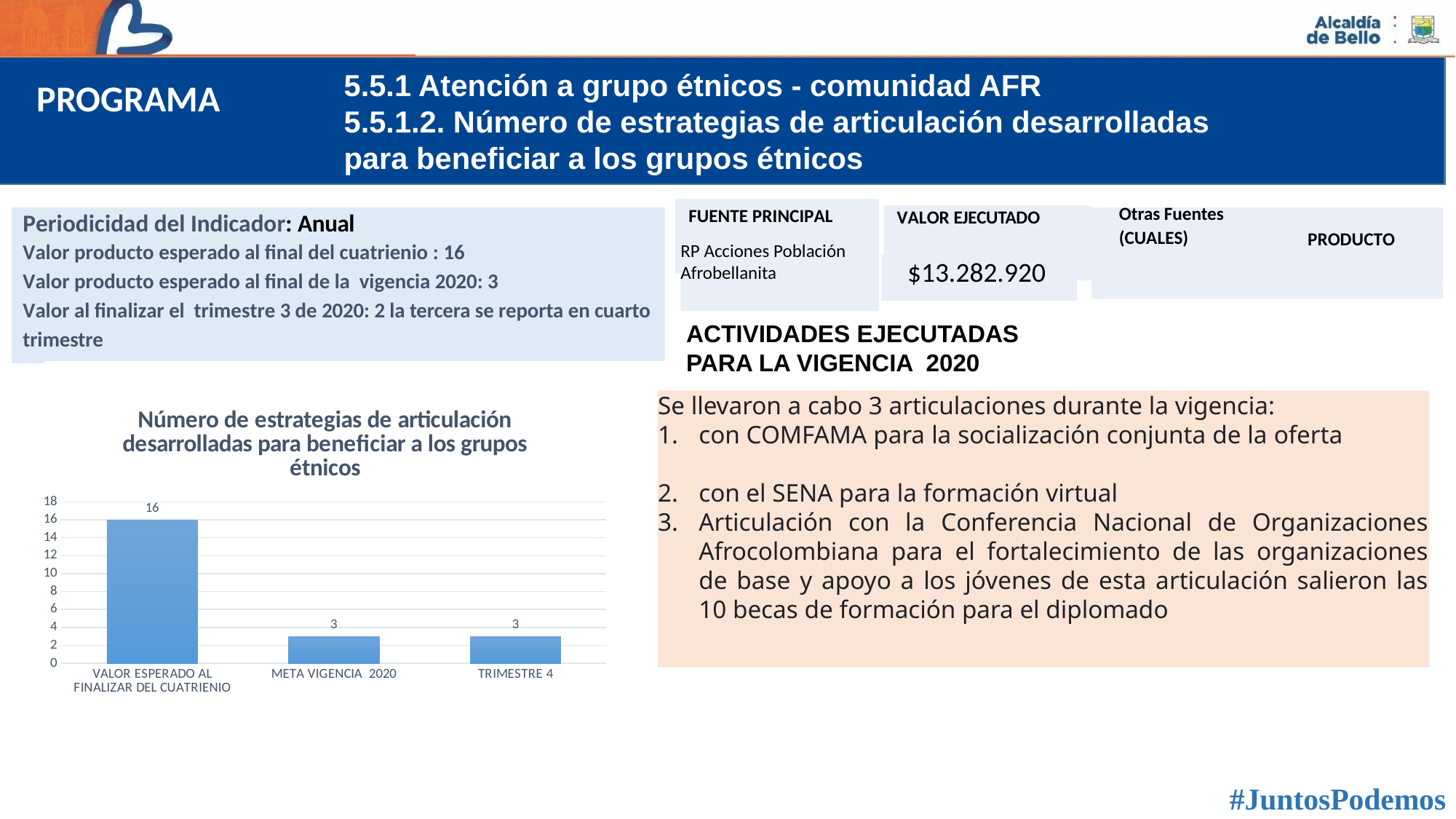
Is the value for VALOR ESPERADO AL FINALIZAR DEL CUATRIENIO greater or less than 10? greater What is the maximum value shown on the chart's y axis? 18 Is the value for META VIGENCIA 2020 greater or less than 10? less What is the title of the chart? Número de estrategias de articulación desarrolladas para beneficiar a los grupos étnicos What is the value for VALOR ESPERADO AL FINALIZAR DEL CUATRIENIO? 16 What is the value for META VIGENCIA 2020? 3 How many categories are shown on the x axis of the chart? 3 What is the difference between the value for VALOR ESPERADO AL FINALIZAR DEL CUATRIENIO and the value for META VIGENCIA 2020? 13 Which is larger, the value for VALOR ESPERADO AL FINALIZAR DEL CUATRIENIO or the value for TRIMESTRE 4? VALOR ESPERADO AL FINALIZAR DEL CUATRIENIO What is the value for TRIMESTRE 4? 3 What kind of chart is shown on the slide? bar chart Which category has the highest value? VALOR ESPERADO AL FINALIZAR DEL CUATRIENIO